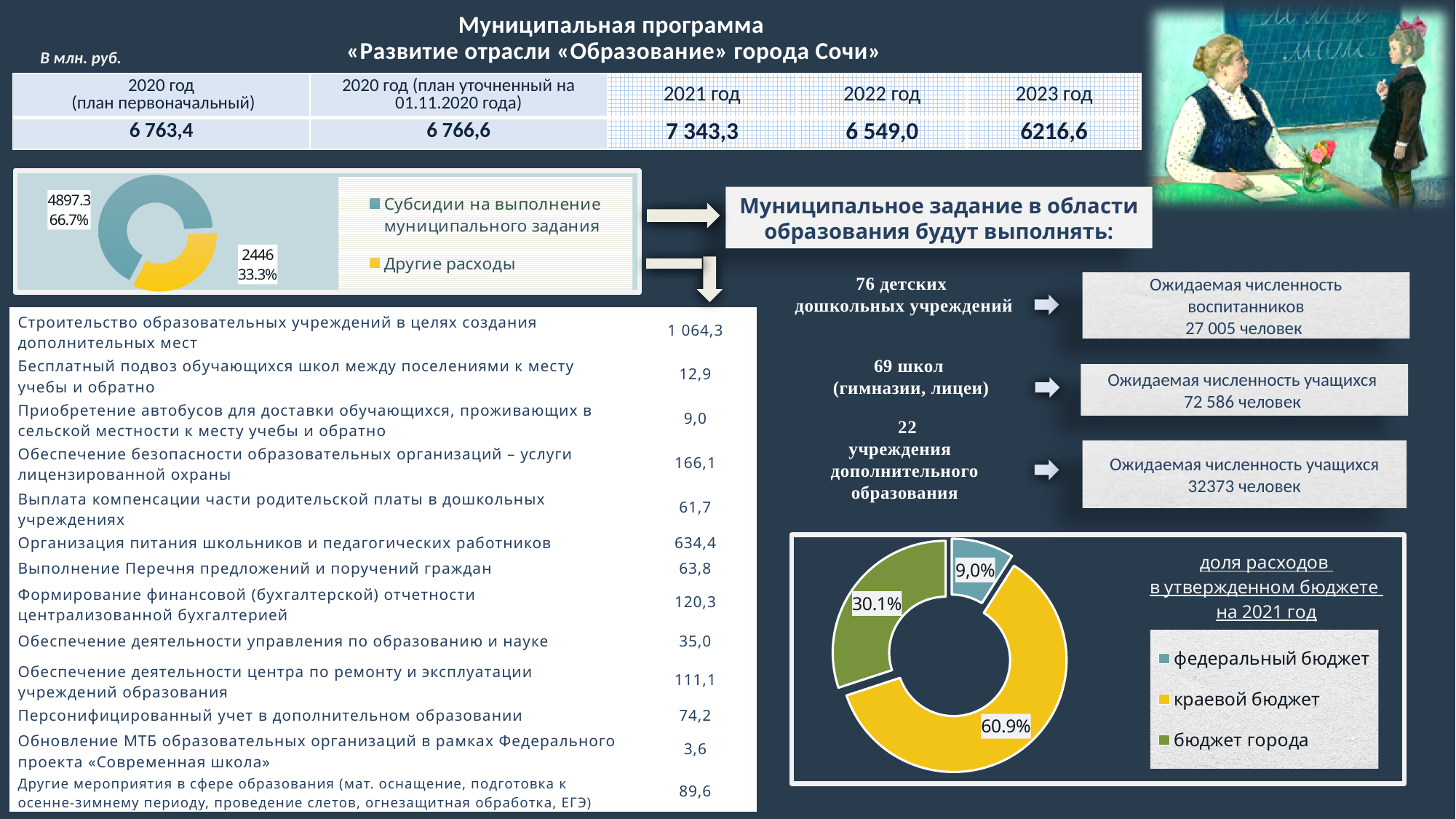
In the chart «доля расходов в утвержденном бюджете на 2021 год» at the bottom right, how many categories does the legend list? 3 In the doughnut chart at the top left of the slide, what share of the total does «Субсидии на выполнение муниципального задания» represent? 66.7% In the doughnut chart at the top left of the slide, what share of the total does «Другие расходы» represent? 33.3% What kind of chart is the chart at the top left of the slide? Doughnut chart In the doughnut chart at the top left of the slide, which category is larger: «Субсидии на выполнение муниципального задания» or «Другие расходы»? Субсидии на выполнение муниципального задания In the chart «доля расходов в утвержденном бюджете на 2021 год» at the bottom right, what share is shown for «федеральный бюджет»? 9,0% In the chart «доля расходов в утвержденном бюджете на 2021 год» at the bottom right, which budget has the largest share? краевой бюджет In the chart «доля расходов в утвержденном бюджете на 2021 год» at the bottom right, which budget has the smallest share? федеральный бюджет In the doughnut chart at the top left of the slide, what value is shown for «Другие расходы»? 2446 How many categories does the legend of the doughnut chart at the top left of the slide list? 2 In the doughnut chart at the top left of the slide, what value is shown for «Субсидии на выполнение муниципального задания»? 4897.3